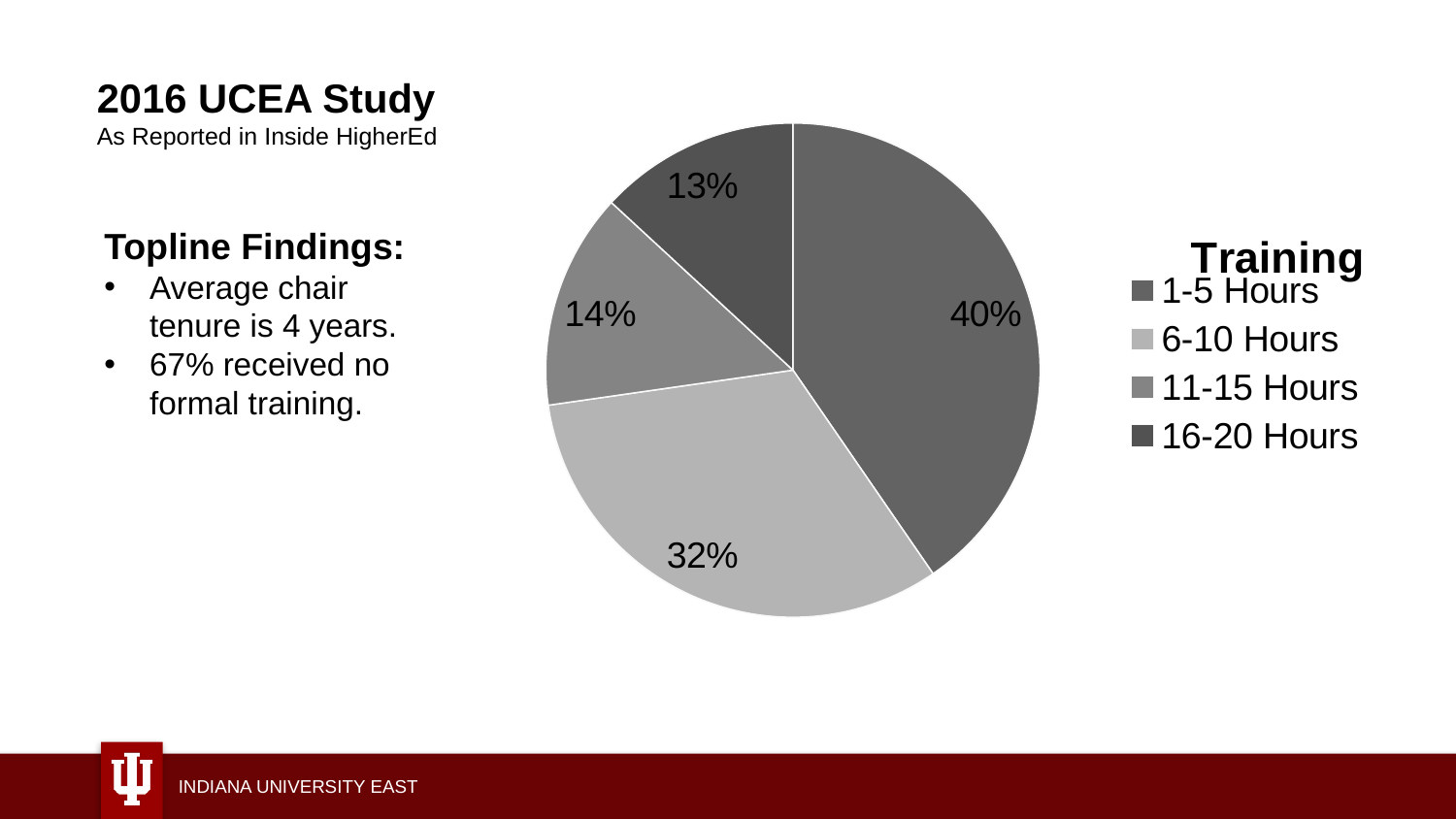
What type of chart is shown on the slide? pie chart What is the combined share of the 1-5 Hours and 6-10 Hours slices? 72% Which is larger, the 11-15 Hours slice or the 16-20 Hours slice? 11-15 Hours What percentage of the pie is the 1-5 Hours slice? 40% What percentage of the pie is the 6-10 Hours slice? 32% Which category has the smallest share of the pie? 16-20 Hours What is the title of the chart? Training How many categories does the legend list? 4 What is the difference in percentage points between the 1-5 Hours slice and the 6-10 Hours slice? 8 Which category has the largest share of the pie? 1-5 Hours What percentage of the pie is the 11-15 Hours slice? 14% What percentage of the pie is the 16-20 Hours slice? 13%